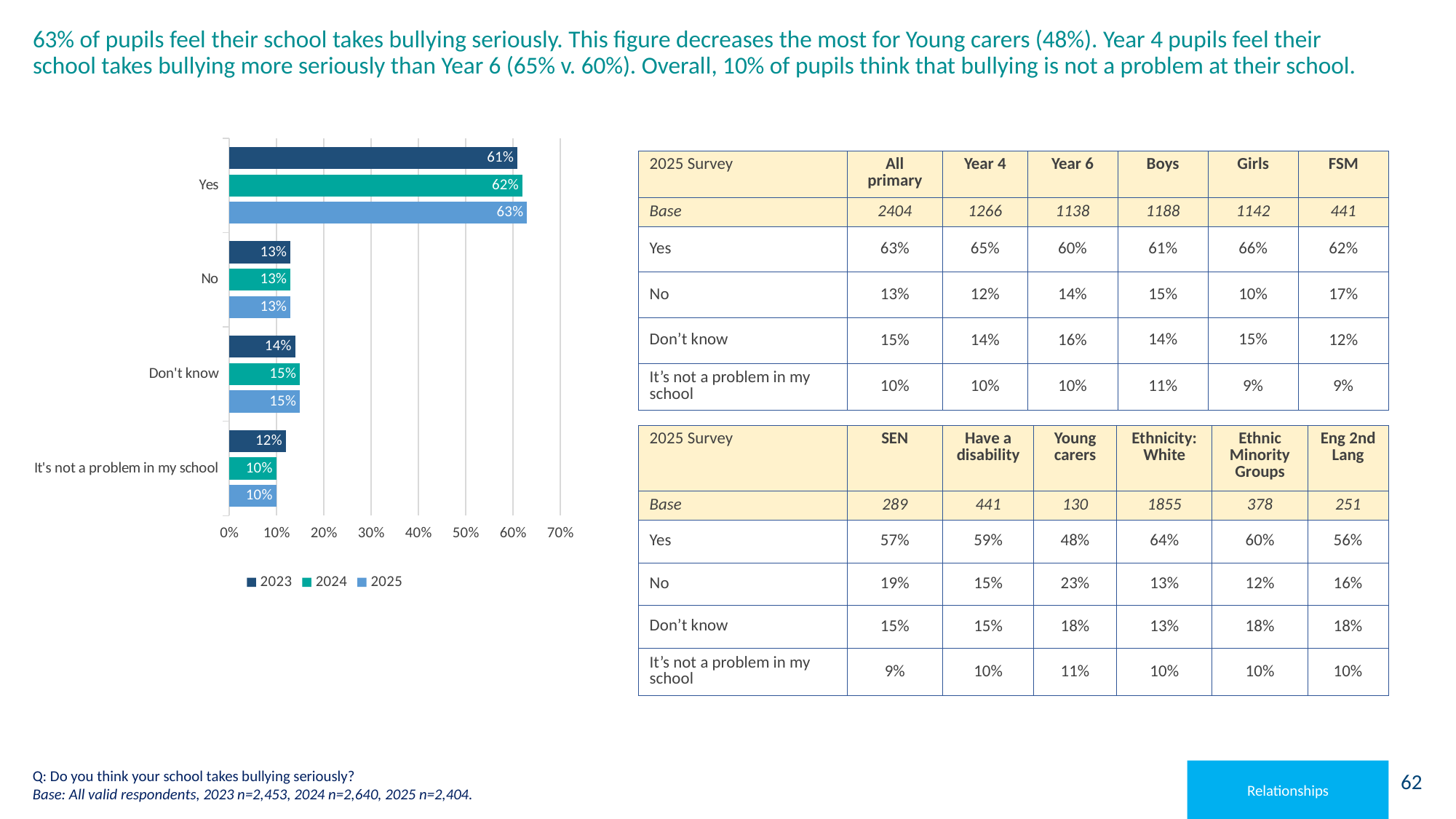
What is the 2023 value for 'It's not a problem in my school' in the bar chart? 12% What is the 2025 value for 'Yes' in the bar chart? 63% What type of chart is shown on the slide? bar chart Which category has the lowest 2025 value in the bar chart? It's not a problem in my school Which years are listed in the legend of the bar chart? 2023, 2024, 2025 Which category has the highest values in the bar chart? Yes In the bar chart, is the 2023 value for 'Don't know' larger or smaller than the 2023 value for 'No'? larger How many categories are shown in the bar chart? 4 What is the difference between the 2025 and 2023 values for 'Yes' in the bar chart? 2% How many series does the legend of the bar chart list? 3 What is the 2024 value for 'Don't know' in the bar chart? 15% Is the 2024 value for 'Yes' in the bar chart greater or less than 50%? greater